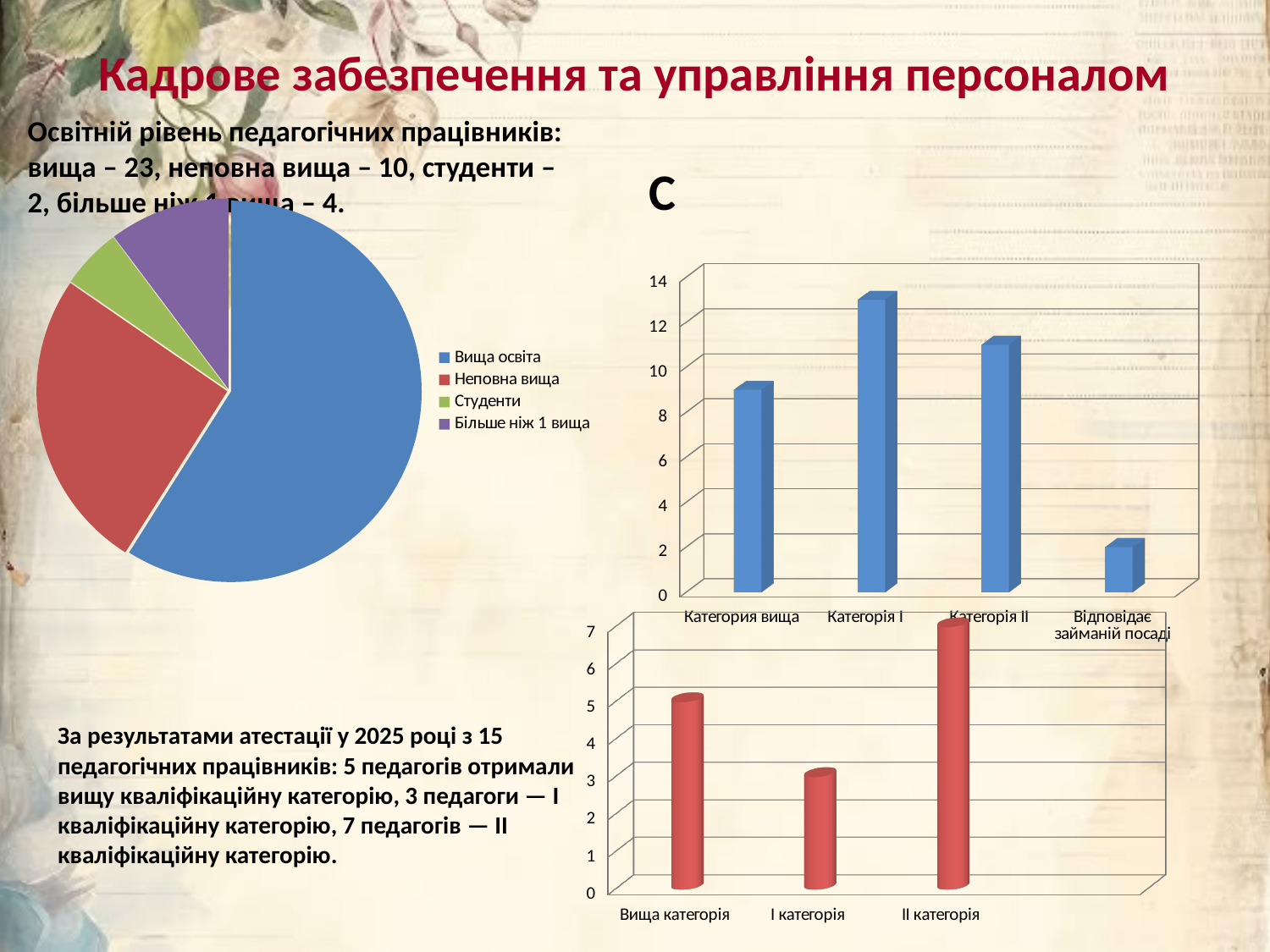
In the pie chart on the left, which category has the largest slice? Вища освіта In the red bar chart at the bottom right, what is the value for ІІ категорія? 7 What kind of chart is the chart on the left of the slide? pie chart In the blue bar chart at the top right, what is the value for Відповідає займаній посаді? 2 How many categories are shown in the red bar chart at the bottom right? 3 In the blue bar chart at the top right, is the value for Категория вища greater or less than 10? less In the blue bar chart at the top right, is the value for Категорія І greater or less than 12? greater In the blue bar chart at the top right, which is larger, the value for Категорія І or the value for Категорія ІІ? Категорія І In the blue bar chart at the top right, which category has the lowest bar? Відповідає займаній посаді In the red bar chart at the bottom right, what is the difference between the values for ІІ категорія and І категорія? 4 In the blue bar chart at the top right, which category has the highest bar? Категорія І How many entries does the legend of the pie chart on the left list? 4